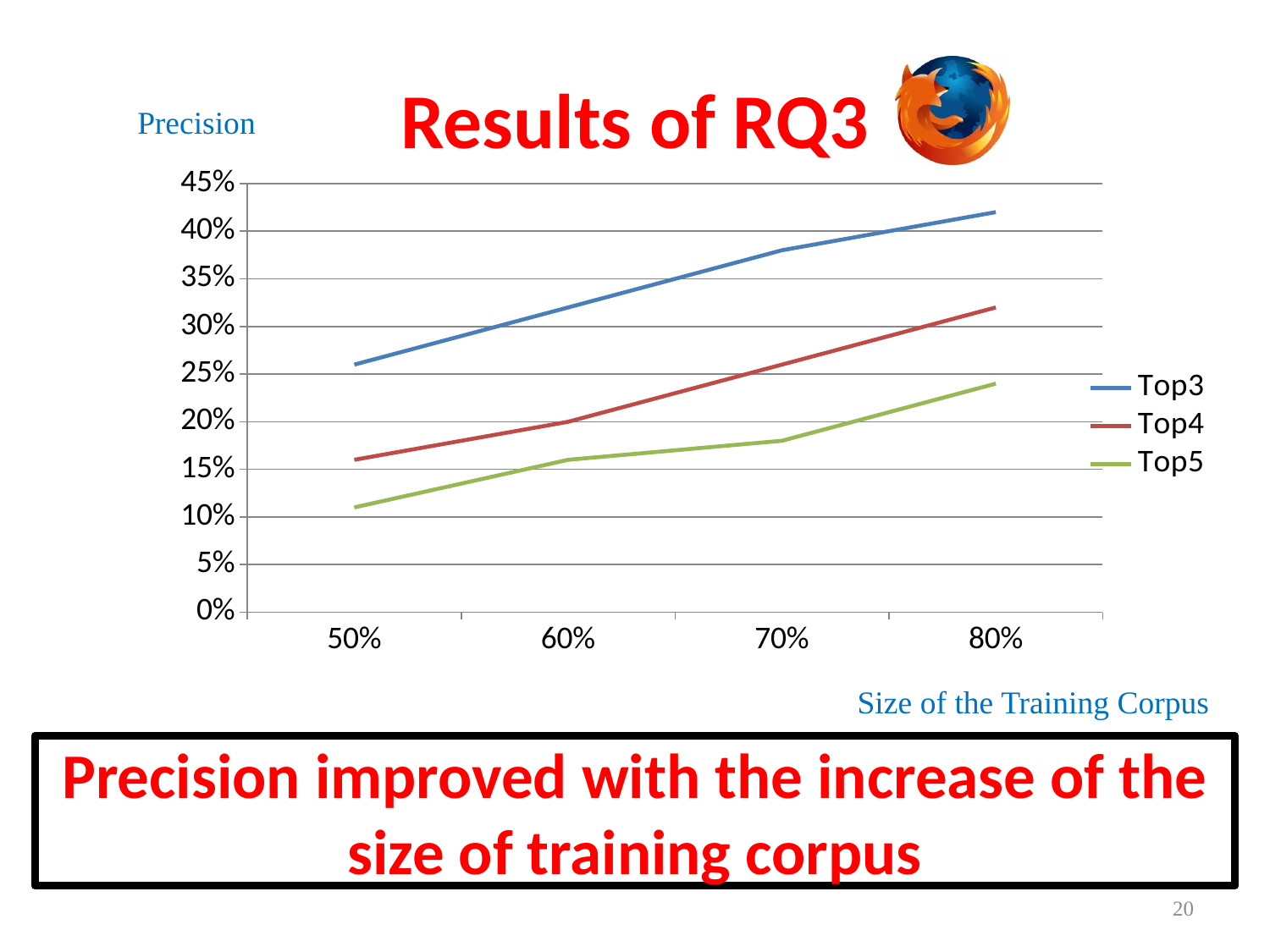
Is the precision for Top5 at 50% greater or less than 15%? less What is the title of the chart? Results of RQ3 Does the precision for Top3 rise or fall as the size of the training corpus increases? rise Which is larger at 60%: the precision for Top4 or for Top5? Top4 Is the precision for Top4 at 70% greater or less than 20%? greater Which series has the lowest precision at 50%? Top5 What kind of chart is shown on the slide? line chart What is the label of the x axis? Size of the Training Corpus How many series does the legend list? 3 Is the precision for Top3 at 80% greater or less than 40%? greater Which series has the highest precision at 80%? Top3 How many training corpus sizes are shown on the x axis? 4